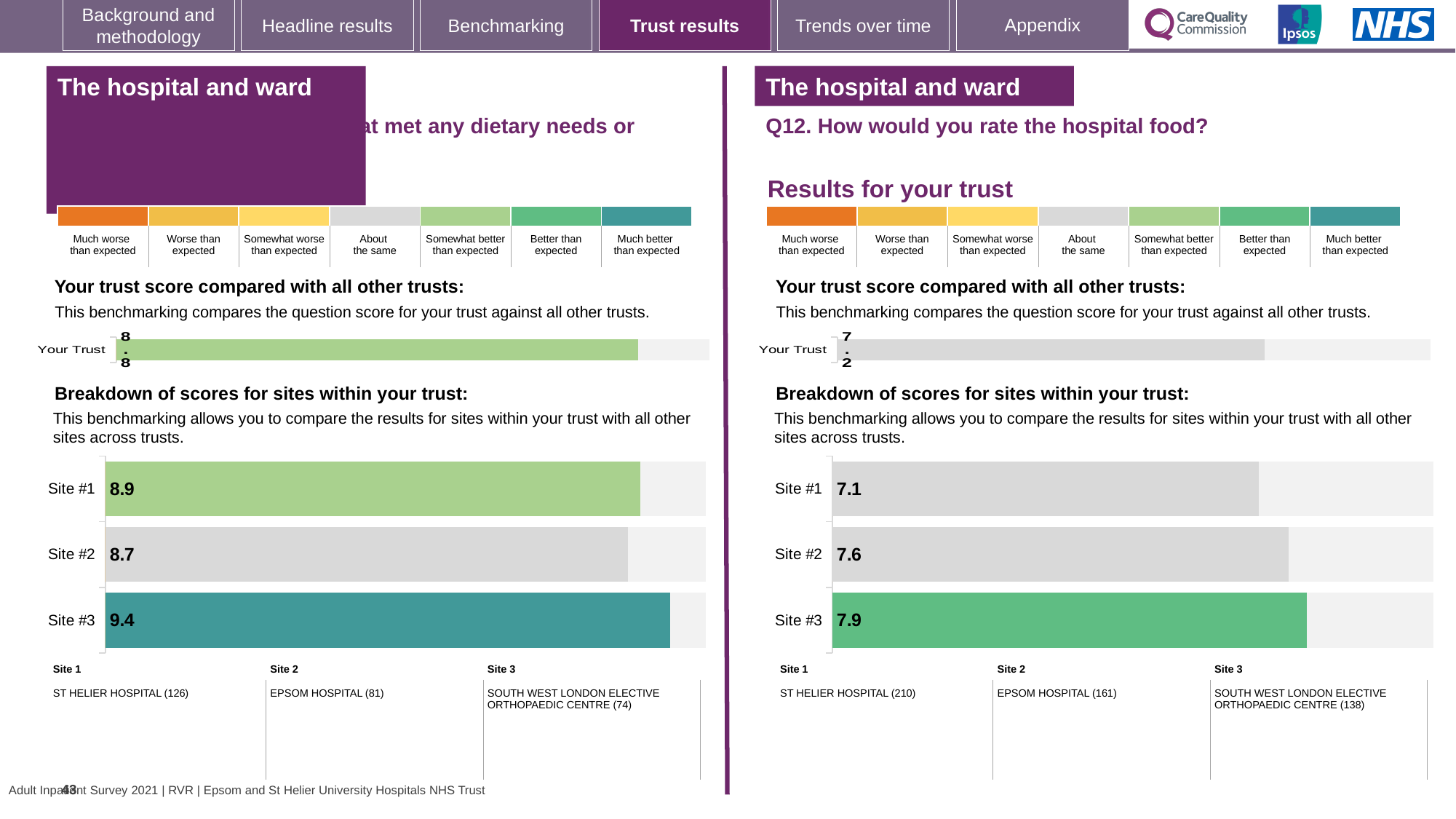
In the right-hand chart (Q12. How would you rate the hospital food?), what is the 'Your Trust' score compared with all other trusts? 7.2 In the right-hand chart (Q12. How would you rate the hospital food?), what is the score for Site #3 in the breakdown of scores for sites within your trust? 7.9 In the right-hand chart (Q12. How would you rate the hospital food?), which hospital is Site 3 according to the key below the chart? SOUTH WEST LONDON ELECTIVE ORTHOPAEDIC CENTRE (138) In the left-hand chart's site breakdown, which has the larger score, Site #1 or Site #2? Site #1 What type of chart is used for the breakdown of scores for sites within your trust on the right-hand side of the slide? Bar chart How many sites are shown in the breakdown of scores in the right-hand chart (Q12. How would you rate the hospital food?)? 3 In the left-hand chart's breakdown of scores for sites within your trust, what is the score for Site #2? 8.7 In the left-hand chart's breakdown of scores for sites, which site has the highest score? Site #3 In the right-hand chart (Q12. How would you rate the hospital food?), which site has the lowest score in the breakdown of sites? Site #1 In the left-hand chart's site breakdown, what is the difference between the scores for Site #3 and Site #2? 0.7 In the left-hand chart, what is the 'Your Trust' score compared with all other trusts? 8.8 In the right-hand chart (Q12. How would you rate the hospital food?), what is the difference between the scores for Site #3 and Site #1? 0.8